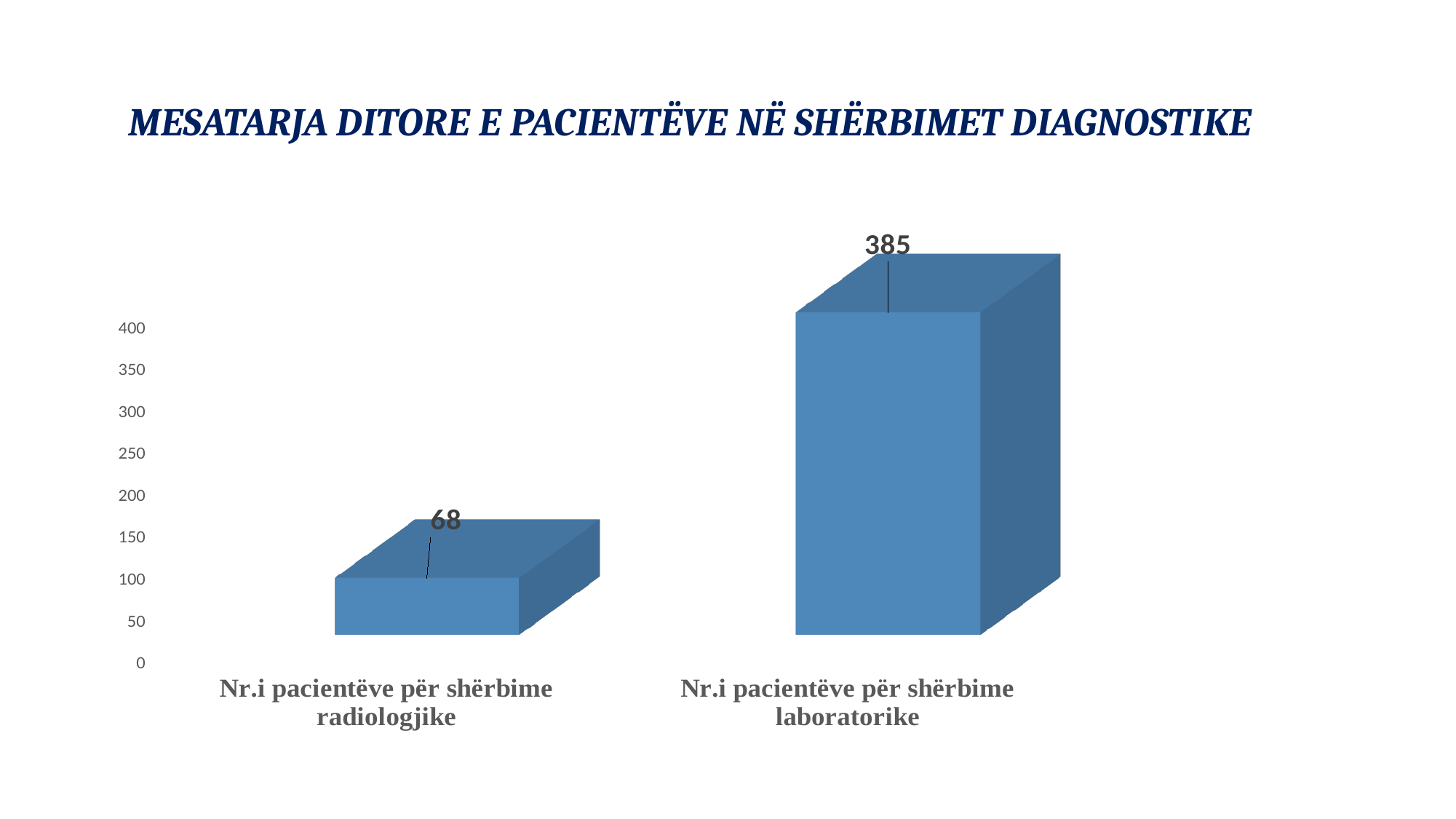
Which category has the highest value? Nr.i pacientëve për shërbime laboratorike Is the value for Nr.i pacientëve për shërbime laboratorike greater or less than 300? greater Is the value for Nr.i pacientëve për shërbime radiologjike greater or less than 100? less What is the value for Nr.i pacientëve për shërbime radiologjike? 68 Which category has the lowest value? Nr.i pacientëve për shërbime radiologjike What kind of chart is shown on the slide? bar chart What is the highest value shown on the vertical axis? 400 What is the value for Nr.i pacientëve për shërbime laboratorike? 385 Which is larger: the value for shërbime radiologjike or the value for shërbime laboratorike? Nr.i pacientëve për shërbime laboratorike What is the title of the slide? MESATARJA DITORE E PACIENTËVE NË SHËRBIMET DIAGNOSTIKE How many categories are shown in the chart? 2 What is the difference between the values for shërbime laboratorike and shërbime radiologjike? 317